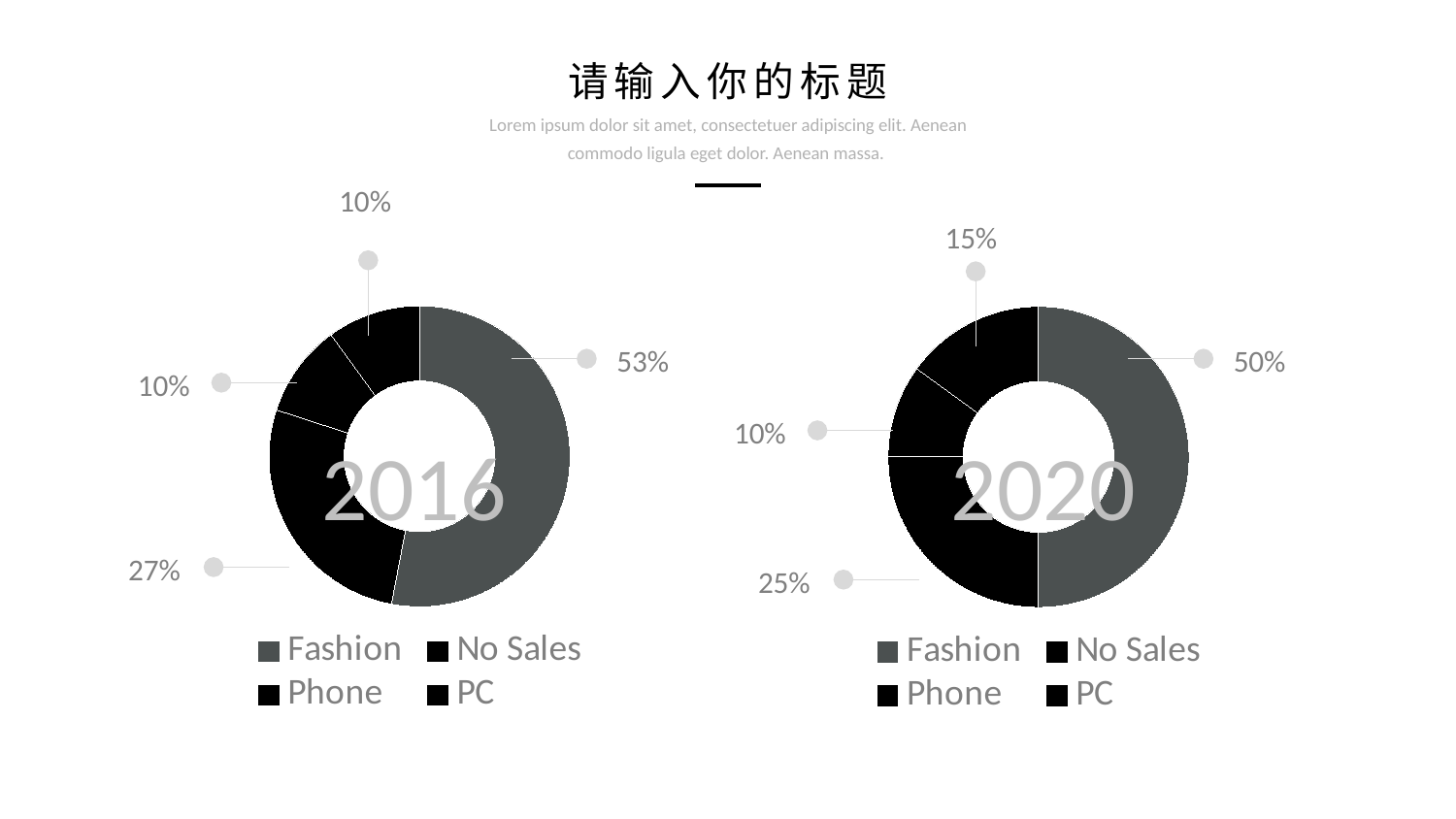
Is the Fashion share larger in the 2016 chart or the 2020 chart? 2016 In the 2016 chart, which category has the largest slice? Fashion How many entries does the legend of the 2016 chart list? 4 In the 2016 chart, what is the difference between the largest slice (53%) and the smallest slice (10%)? 43% What is the difference between the Fashion share in the 2016 chart and in the 2020 chart? 3% How many slices does the 2020 chart have? 4 In the 2020 chart, which category has the largest slice? Fashion In the 2016 chart, what share does Fashion have? 53% In the 2020 chart, what is the smallest percentage shown? 10% What type of chart is the 2016 chart? Doughnut (pie) chart In the 2016 chart, what is the largest percentage shown? 53% In the 2020 chart, what share does Fashion have? 50%